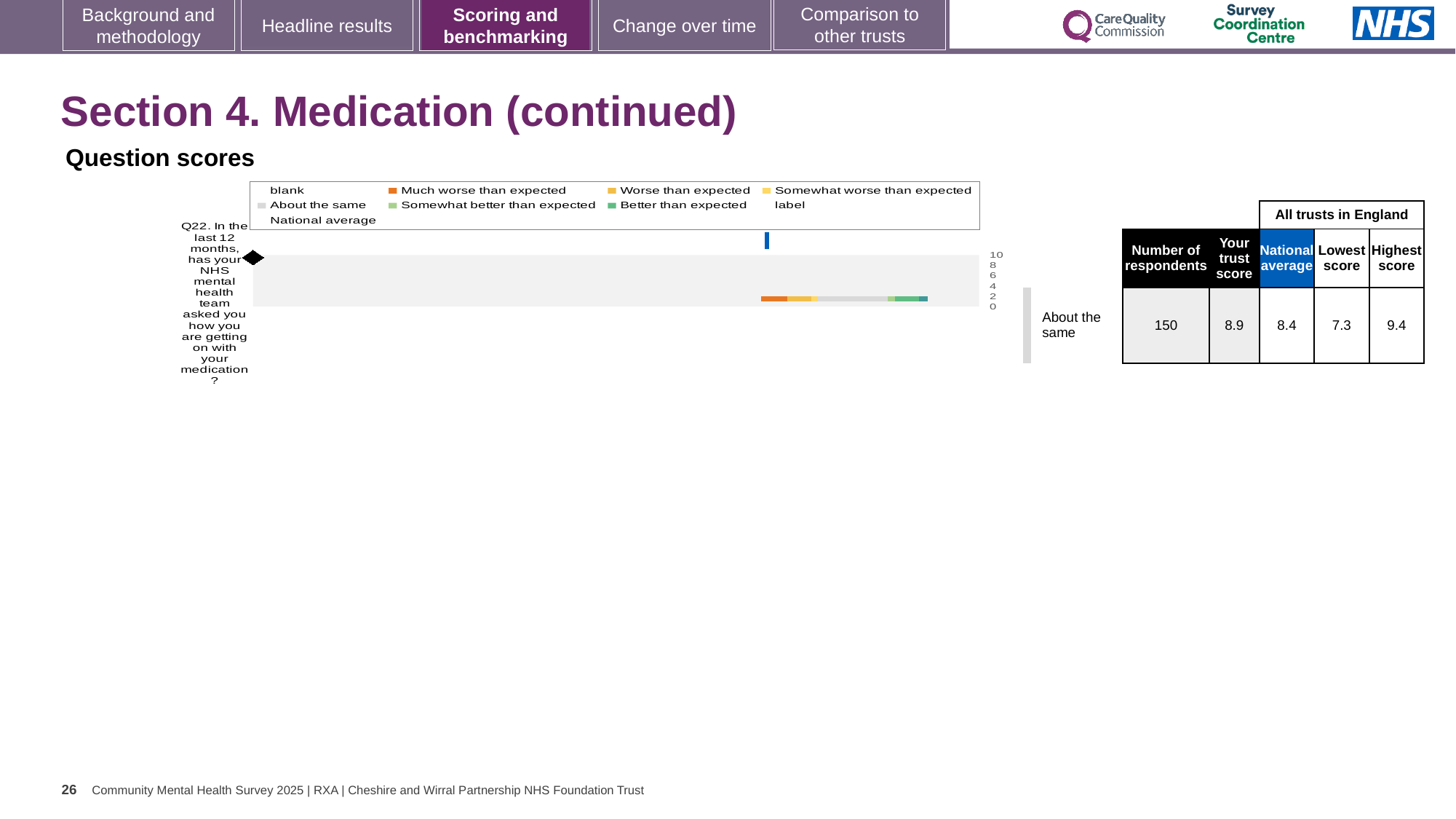
How many survey questions are plotted in the chart? 1 How many respondents answered Q22? 150 What is the national average score for Q22? 8.4 What is the highest score among all trusts in England for Q22? 9.4 Which survey question is plotted in the chart? Q22 What is the lowest score among all trusts in England for Q22? 7.3 Which is larger for Q22: the trust score or the national average? the trust score What is the trust score for Q22? 8.9 What is the difference between the highest and lowest scores for Q22 across all trusts in England? 2.1 Is the trust score for Q22 greater or less than 8? greater Which benchmark category is Q22 placed in, according to the label next to the chart? About the same What type of chart is shown on the slide? bar chart